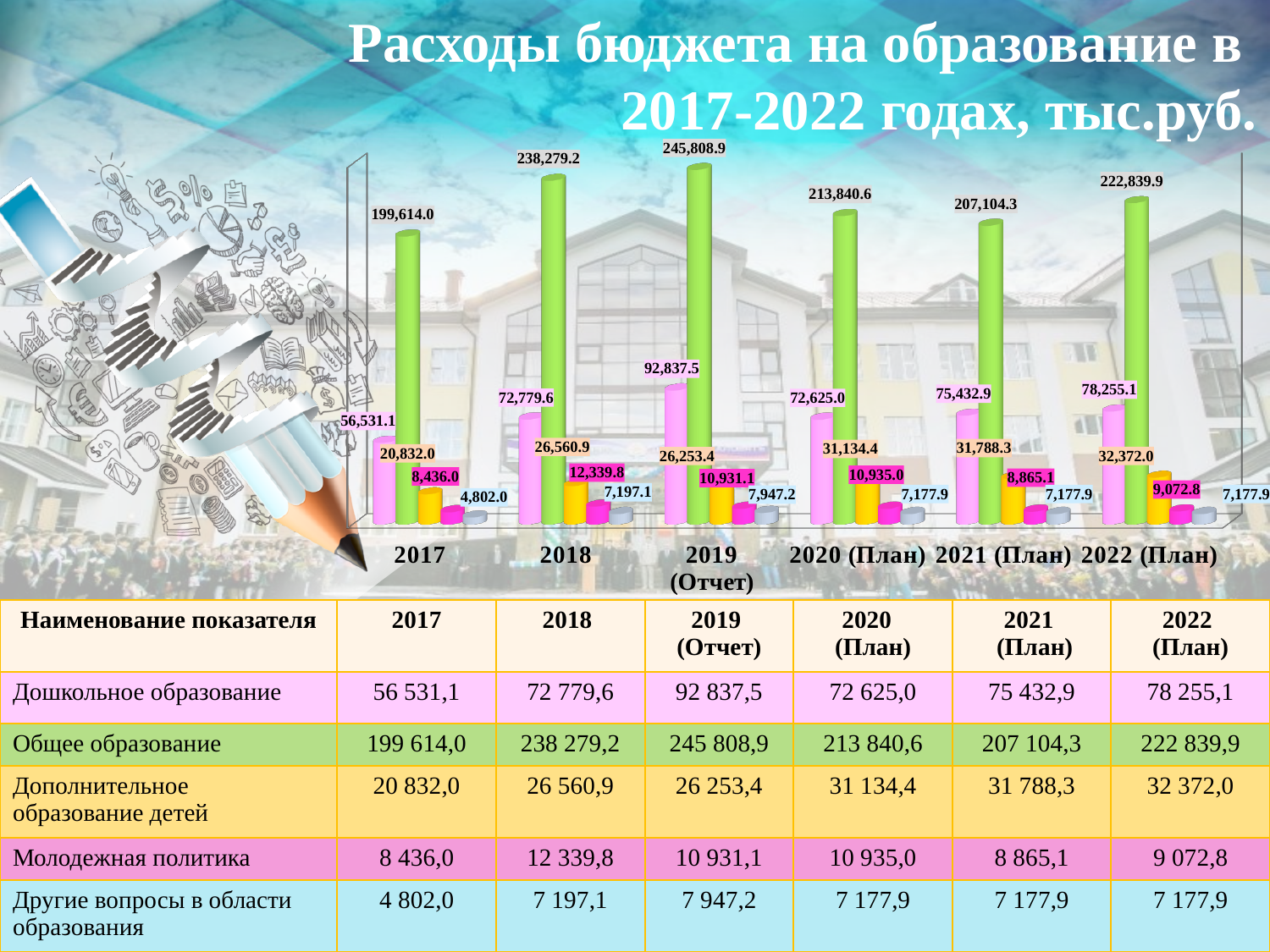
Does the green bar (Общее образование) rise or fall from 2017 to 2019 (Отчет)? rise What is the difference between the Общее образование values for 2018 and 2017? 38,665.2 In which year is the light blue bar (Другие вопросы в области образования) the lowest? 2017 Which is larger, the Дополнительное образование детей value for 2022 (План) or for 2021 (План)? 2022 (План) How many year categories are shown on the x axis of the chart? 6 What is the difference between the Дошкольное образование values for 2019 (Отчет) and 2017? 36,306.4 What is the value of the green bar (Общее образование) for 2019 (Отчет)? 245,808.9 What is the value of the magenta bar (Молодежная политика) for 2018? 12,339.8 What is the value of the pink bar (Дошкольное образование) for 2021 (План)? 75,432.9 What type of chart is shown on the slide? bar chart In which year is the green bar (Общее образование) the highest? 2019 (Отчет) In which year is the pink bar (Дошкольное образование) the lowest? 2017